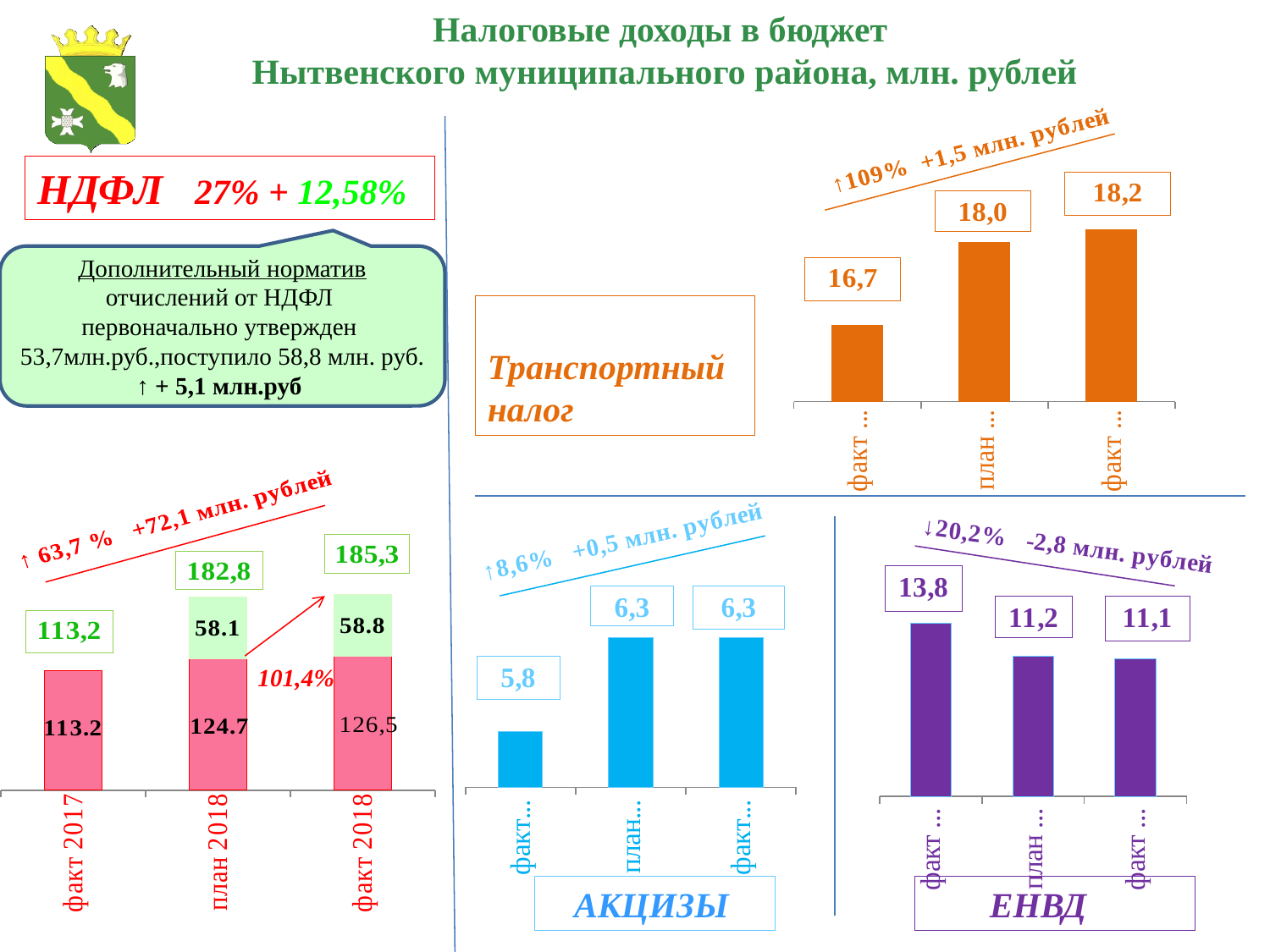
On the НДФЛ chart (bottom left), what is the value of the pink (lower) segment for факт 2018? 126,5 On the АКЦИЗЫ chart, what is the difference between the middle bar (план) and the first bar (факт)? 0,5 On the Транспортный налог chart, which bar is the highest? the third bar (факт), 18,2 On the Транспортный налог chart, what is the value of the middle bar (план)? 18,0 On the ЕНВД chart, what is the value of the first bar (факт)? 13,8 On the Транспортный налог chart, what is the value of the first bar (факт)? 16,7 What type of chart is the Транспортный налог chart? bar chart On the ЕНВД chart, which bar is the lowest? the third bar (факт), 11,1 On the ЕНВД chart, do the values rise or fall from left to right? fall On the НДФЛ chart (bottom left), what is the total of the stacked bar for план 2018? 182,8 On the АКЦИЗЫ chart, what is the value of the first bar (факт)? 5,8 On the НДФЛ chart (bottom left), how many bars are there? 3